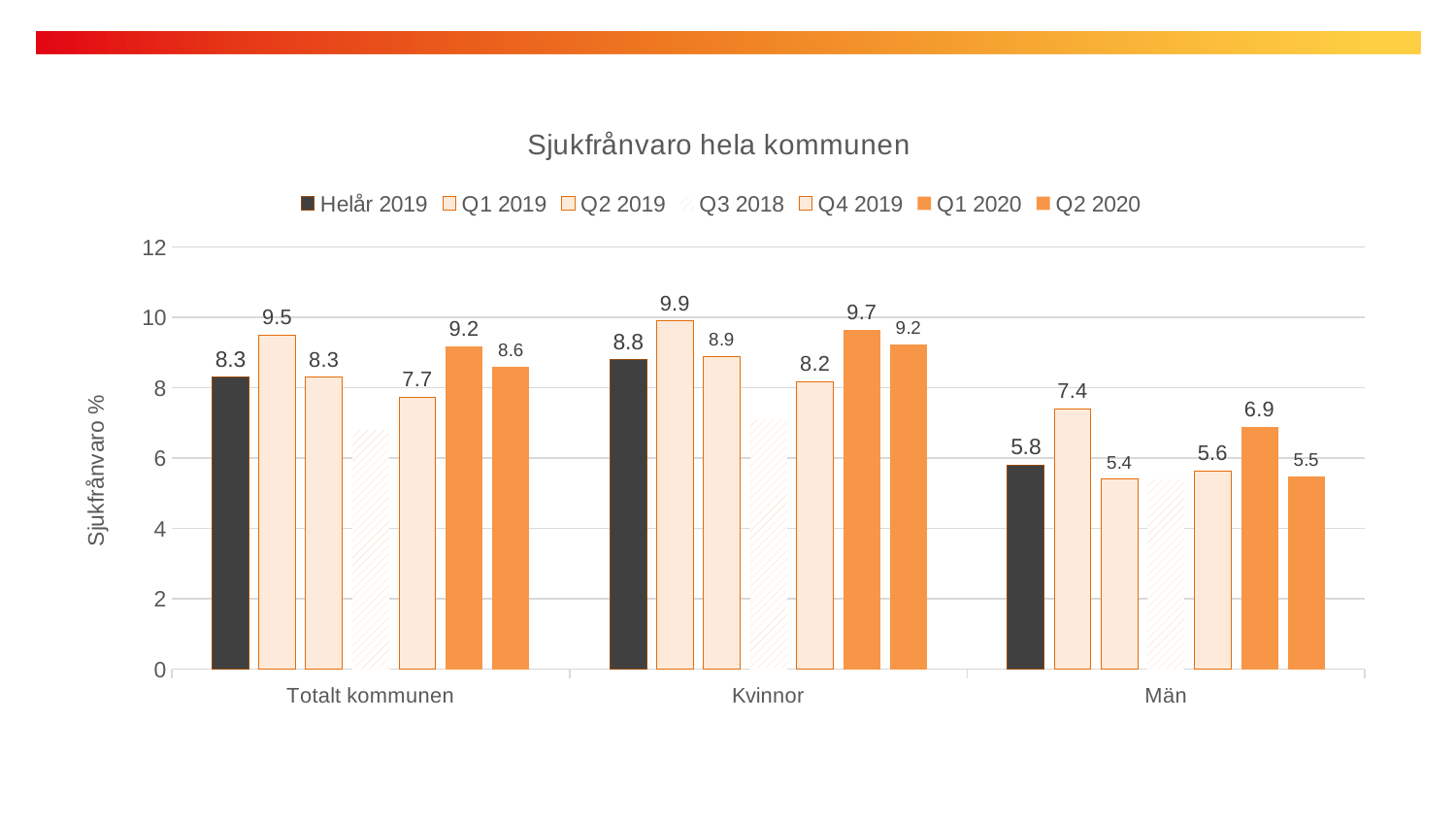
What is the Q1 2019 value for Kvinnor? 9.9 Is the Q3 2018 value for Kvinnor greater or less than 8? less Which category has the lowest Q1 2019 value? Män How many categories are shown on the x axis? 3 What is the Helår 2019 value for Totalt kommunen? 8.3 What is the difference between the Q1 2019 and Q4 2019 values for Män? 1.8 What is the Q2 2020 value for Män? 5.5 How many series does the legend list? 7 What is the Q4 2019 value for Kvinnor? 8.2 What kind of chart is shown on the slide? bar chart Which is larger for Totalt kommunen: the Q1 2020 value or the Q2 2020 value? Q1 2020 Which category has the highest Q1 2020 value? Kvinnor